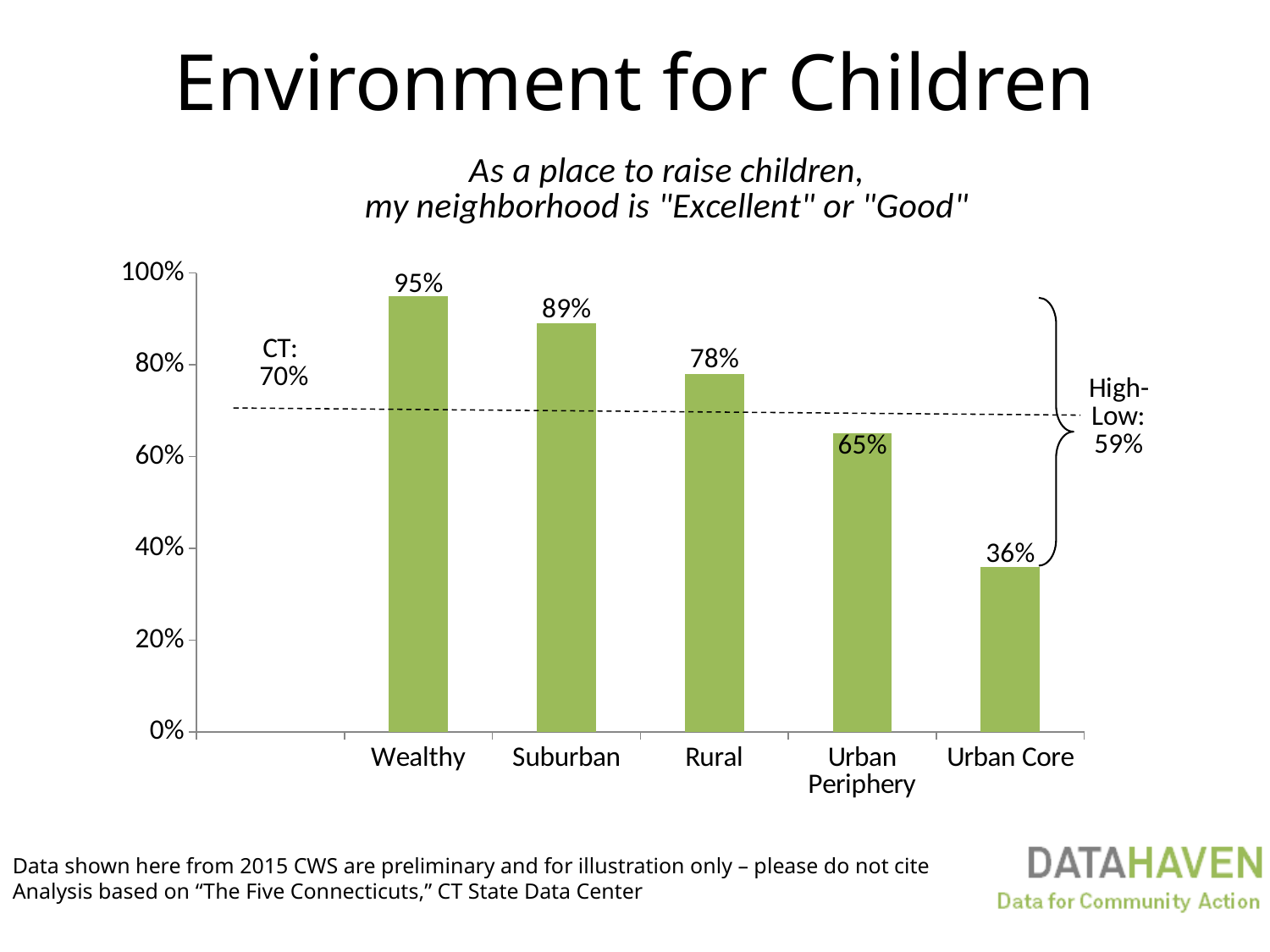
Which is larger, the value for Suburban or the value for Rural? Suburban Which category has the highest value? Wealthy What is the value shown for Urban Periphery? 65% What is the value shown for Rural? 78% What kind of chart is shown on the slide? bar chart What is the difference between the Suburban and Urban Core values? 53% Which category has the lowest value? Urban Core What High-Low difference is annotated on the chart? 59% How many categories are shown on the x axis? 5 What percentage of Wealthy respondents rate their neighborhood as "Excellent" or "Good" as a place to raise children? 95% Is the value for Urban Core greater or less than 40%? less What is the CT value marked by the dashed line? 70%